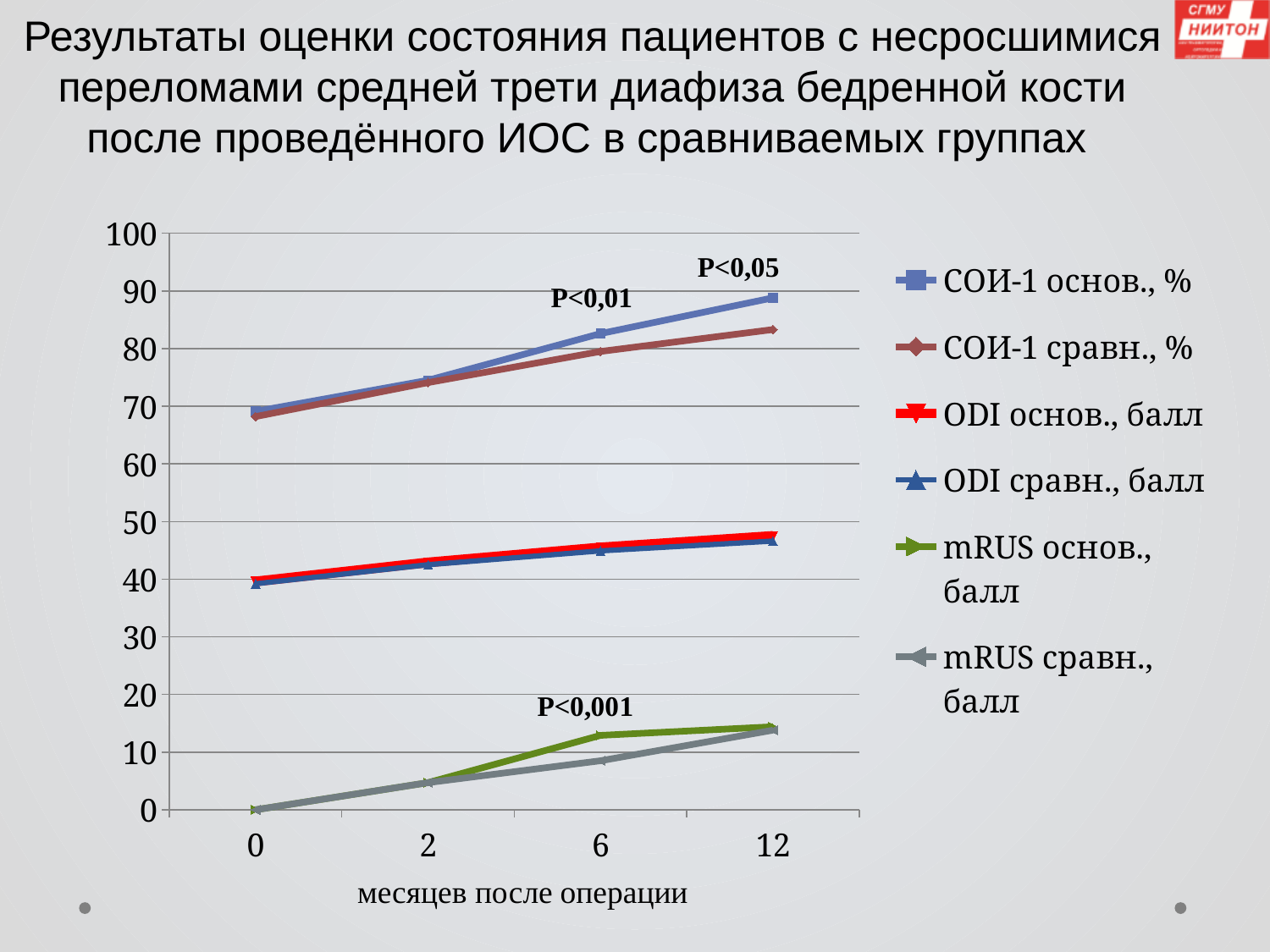
What kind of chart is shown on the slide? line chart Is the value for СОИ-1 основ., % at 12 months greater or less than 80? greater Is the value for mRUS основ., балл at 6 months greater or less than 10? greater What P-value annotation is printed near the mRUS lines? P<0,001 At 6 months, which is larger: mRUS основ., балл or mRUS сравн., балл? mRUS основ., балл Is the value for ODI основ., балл at 12 months greater or less than 50? less Do the values for СОИ-1 основ., % rise or fall from 0 to 12 months? rise How many time points are plotted along the x axis? 4 At 12 months, which is larger: СОИ-1 основ., % or СОИ-1 сравн., %? СОИ-1 основ., % What is the title of the x axis? месяцев после операции How many series does the legend list? 6